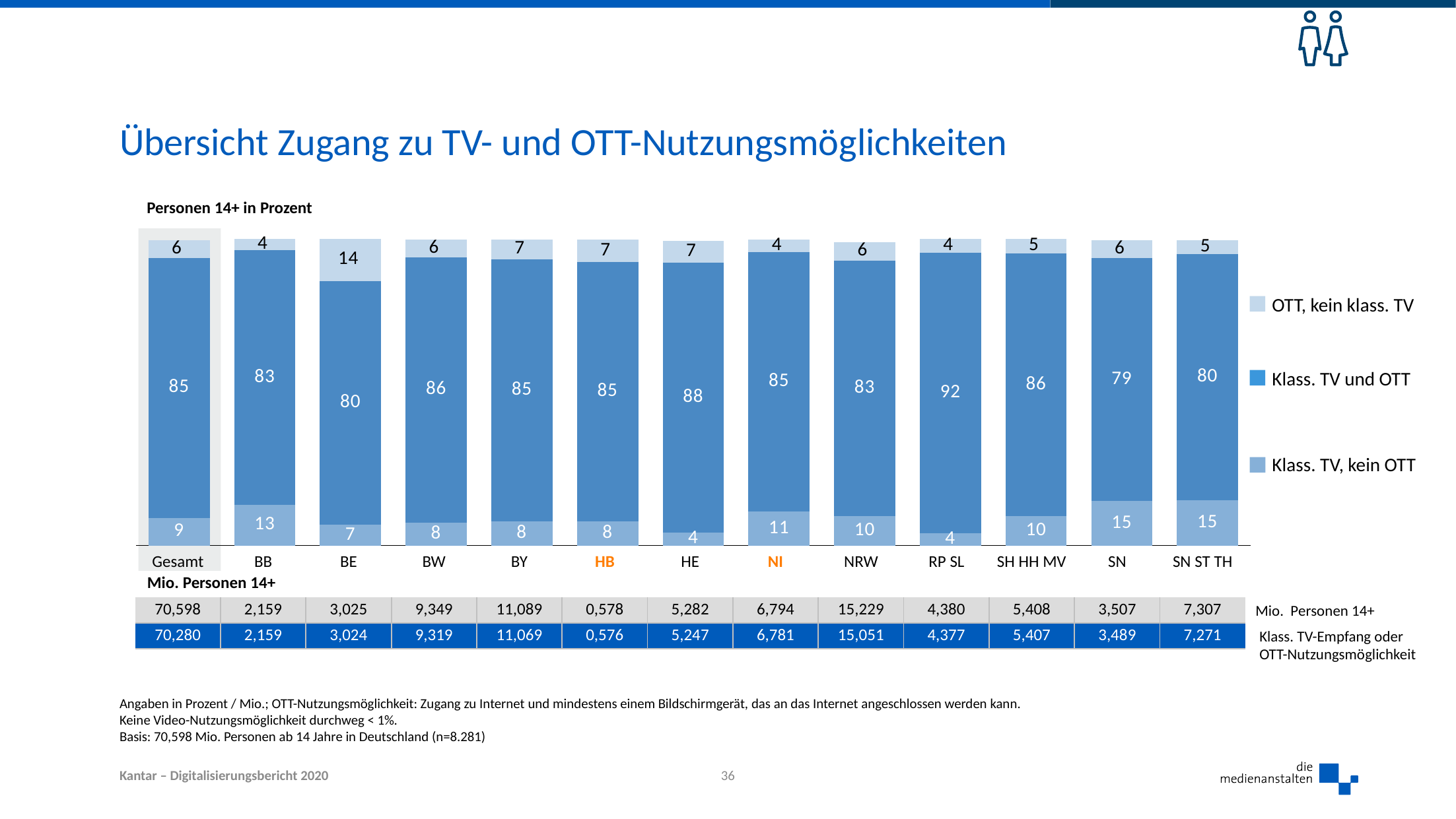
What kind of chart is shown on the slide? Stacked bar chart Which category has the highest value for "Klass. TV und OTT"? RP SL What is the value for "Klass. TV, kein OTT" for BB? 13 Which is larger, the "Klass. TV, kein OTT" value for NI or for NRW? NI What is the value for "OTT, kein klass. TV" for BE? 14 How many series does the legend list? 3 What is the difference between the "Klass. TV und OTT" values for HE and SN? 9 Which category has the lowest value for "Klass. TV und OTT"? SN What is the total of the stacked bar for Gesamt? 100 What is the value for "Klass. TV und OTT" for RP SL? 92 What is the title of the slide? Übersicht Zugang zu TV- und OTT-Nutzungsmöglichkeiten How many categories are shown on the x axis of the chart? 13